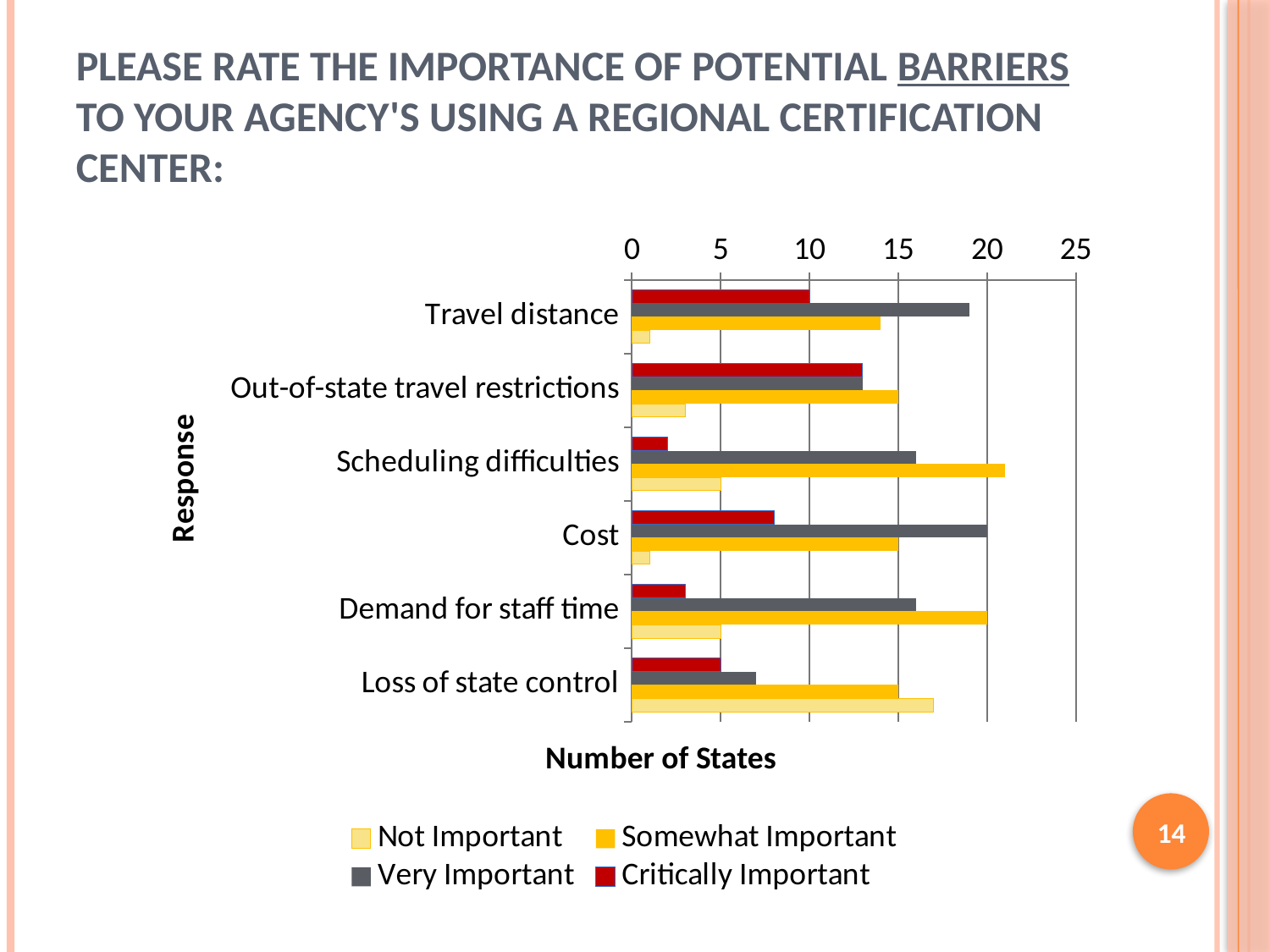
What kind of chart is shown on the slide? bar chart How many states rated Cost as Very Important? 20 How many states rated Travel distance as Critically Important? 10 How many barrier categories are listed on the y axis of the chart? 6 Is the Critically Important value for Scheduling difficulties greater or less than 5? less Is the Not Important value for Loss of state control greater or less than 15? greater What is the label of the x axis? Number of States How many series does the chart legend list? 4 Which barrier has the shortest Very Important bar? Loss of state control Is the Critically Important value for Out-of-state travel restrictions greater or less than 10? greater Which barrier has the longest Somewhat Important bar? Scheduling difficulties Which is larger: the Very Important value for Travel distance or the Very Important value for Loss of state control? Travel distance